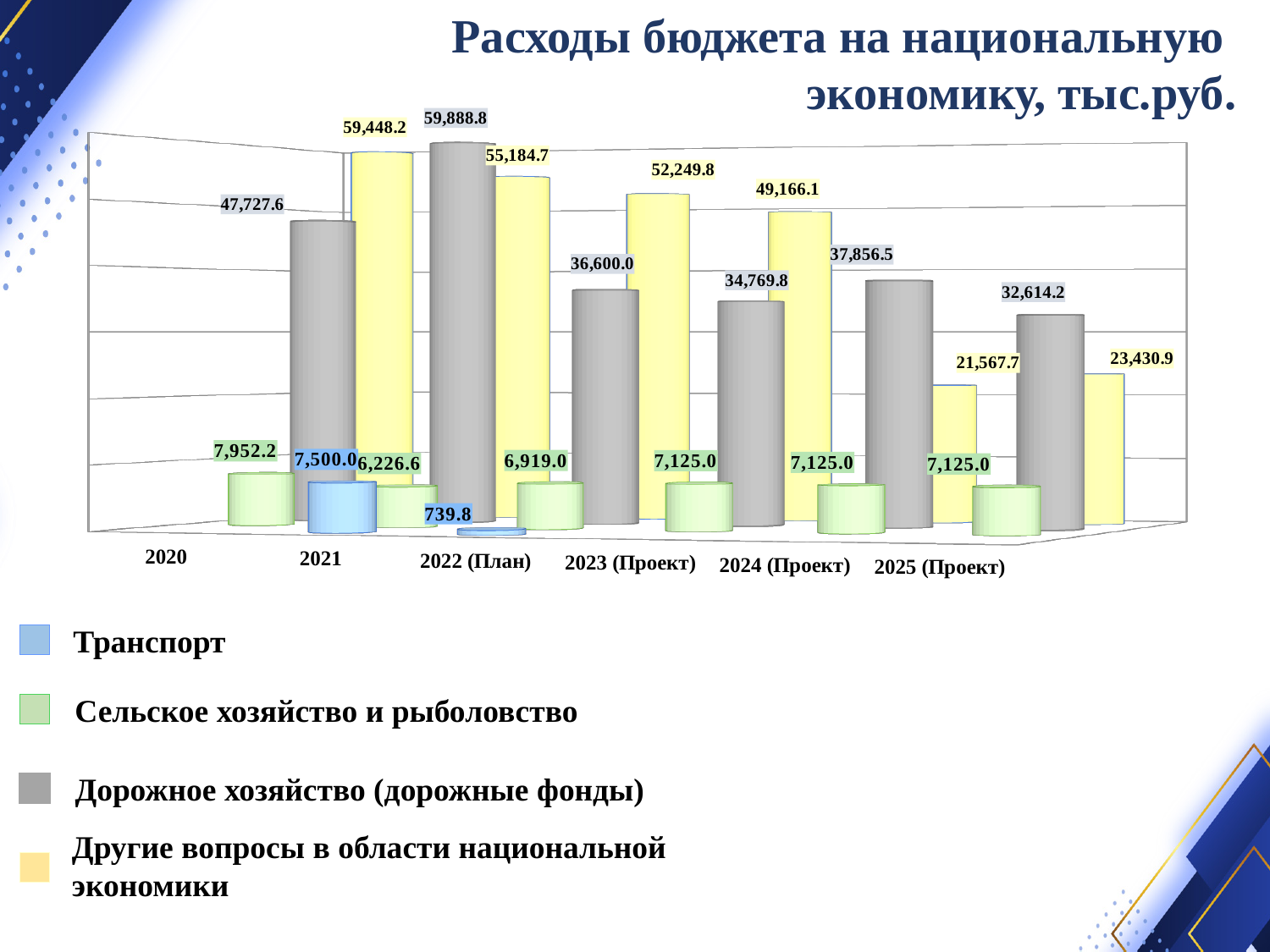
What is the value for Сельское хозяйство и рыболовство in 2020? 7,952.2 Which is larger in 2020: the value for Дорожное хозяйство (дорожные фонды) or the value for Другие вопросы в области национальной экономики? Другие вопросы в области национальной экономики What is the value for Сельское хозяйство и рыболовство in 2025 (Проект)? 7,125.0 What is the lowest value shown for Другие вопросы в области национальной экономики in the chart? 21,567.7 Which series is shown in gray in the chart? Дорожное хозяйство (дорожные фонды) What is the difference between the Дорожное хозяйство (дорожные фонды) values for 2021 (59,888.8) and 2020 (47,727.6)? 12,161.2 What is the highest value shown for Дорожное хозяйство (дорожные фонды) in the chart? 59,888.8 How many categories (years) are shown on the x axis of the chart? 6 How many series does the legend of the chart list? 4 What is the value for Транспорт in 2021? 7,500.0 What is the title of the chart? Расходы бюджета на национальную экономику, тыс.руб. What kind of chart is shown on the slide? bar chart